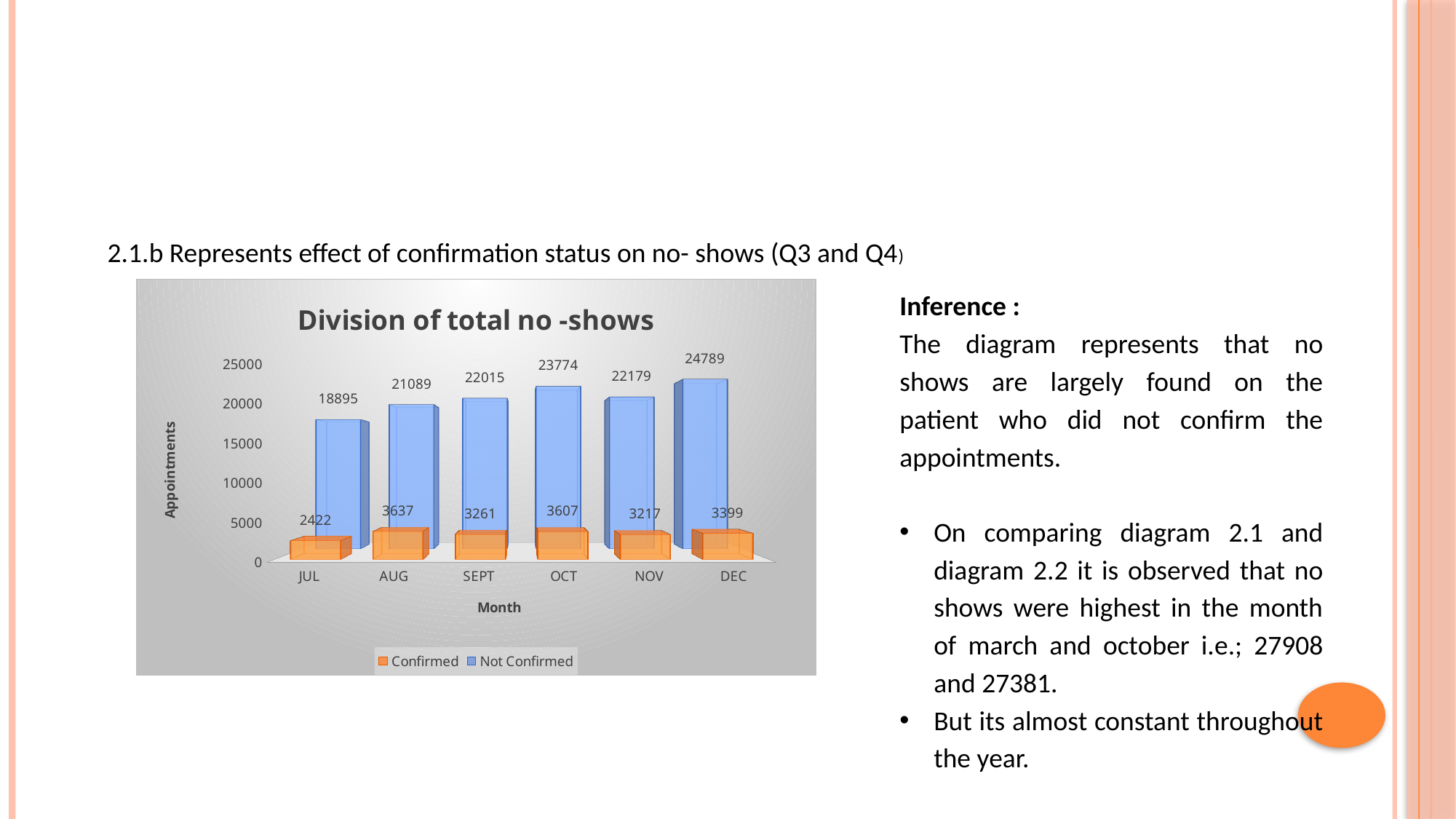
How many months are shown on the x axis? 6 What is the difference between the Not Confirmed values for DEC and JUL? 5894 What is the title of the chart? Division of total no -shows What kind of chart is shown? bar chart Is the Not Confirmed value for JUL greater or less than 20000? less How many series does the legend list? 2 Which is larger, the Confirmed value for AUG or the Confirmed value for OCT? AUG Which month has the highest Not Confirmed value? DEC What is the Confirmed value for NOV? 3217 What is the Confirmed value for JUL? 2422 Which month has the lowest Confirmed value? JUL What is the Not Confirmed value for OCT? 23774